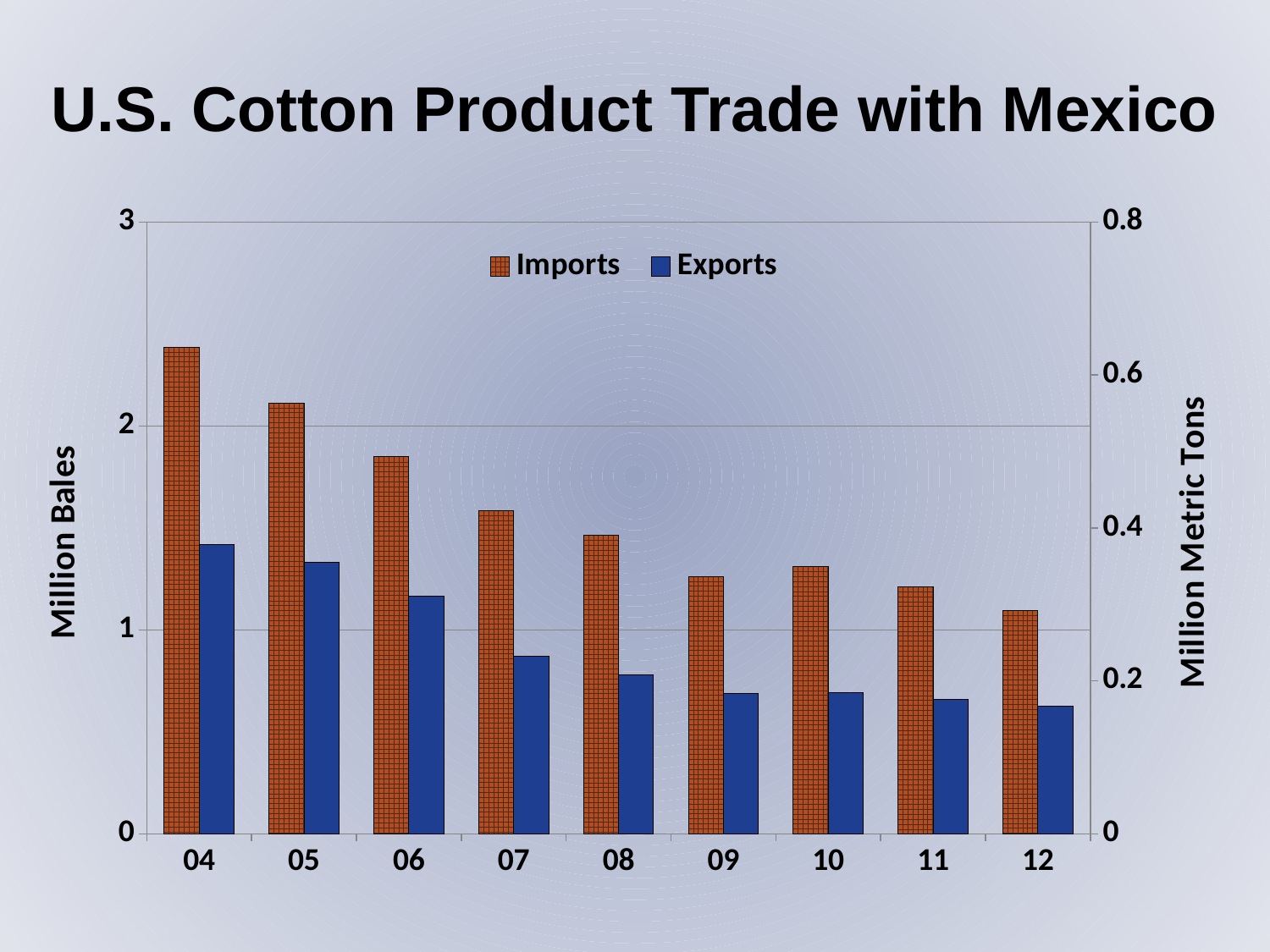
Is the Imports value for 06 greater or less than 2 million bales? less Is the Imports value for 04 greater or less than 2 million bales? greater Is the Exports value for 07 greater or less than 1 million bales? less In which year are Imports highest? 04 How many years are shown on the x axis? 9 How many series does the legend list? 2 In 04, which is larger, Imports or Exports? Imports In which year are Imports lowest? 12 What is the label on the left vertical axis? Million Bales In which year are Exports highest? 04 What kind of chart is shown on the slide? bar chart Do Imports generally rise or fall from 04 to 12? fall